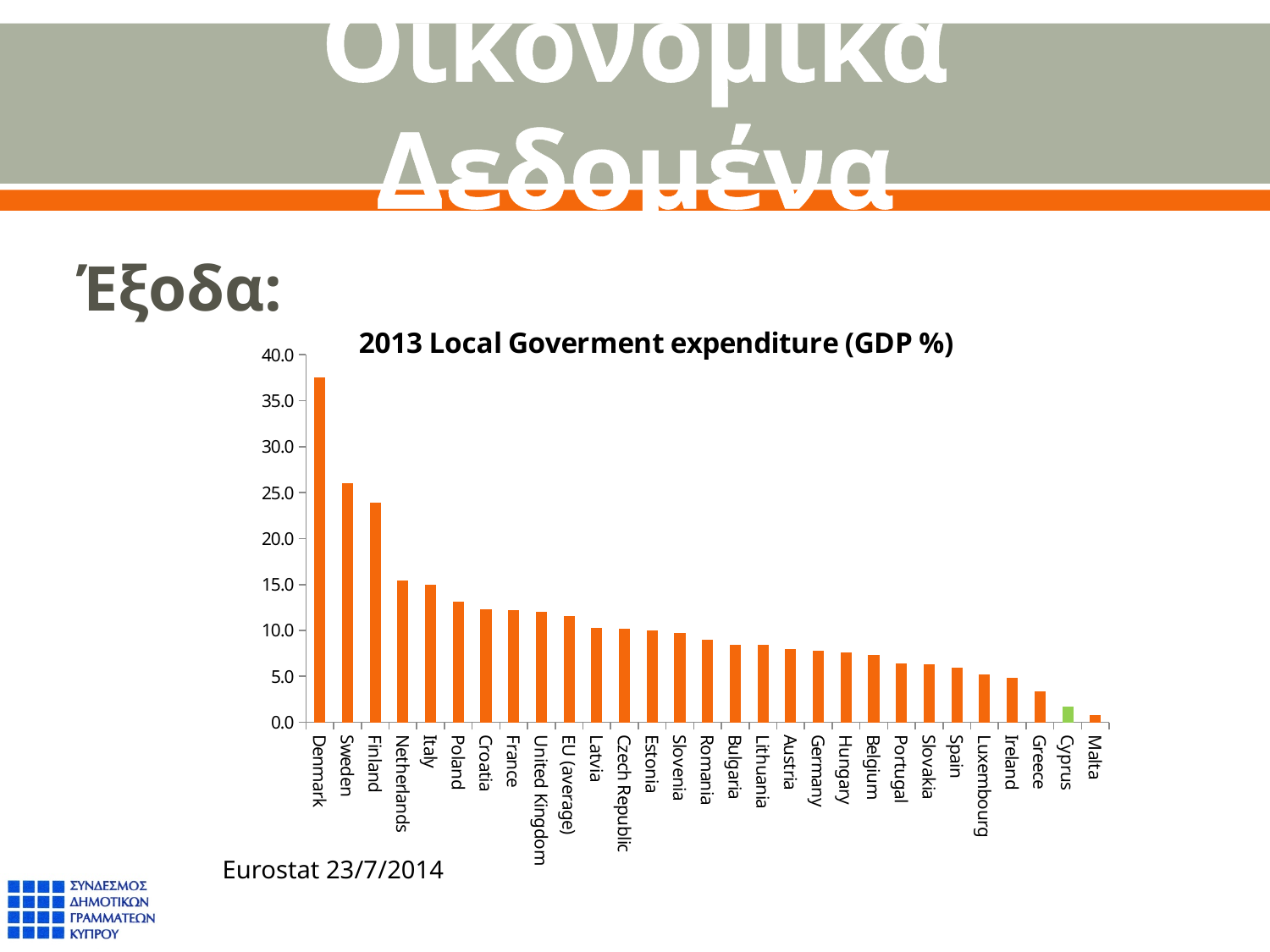
Do the values rise or fall moving from left to right along the x axis? fall What is the title of the chart? 2013 Local Goverment expenditure (GDP %) How many categories (bars) are plotted in the chart? 29 Is the value for Finland greater or less than 20? greater Which has a higher value, Sweden or Finland? Sweden Is the value for Cyprus greater or less than 5? less Is the value for Denmark greater or less than 35? greater Which country has the lowest local government expenditure in the chart? Malta What kind of chart is shown on the slide? bar chart Which country's bar is shown in a different colour (green) from the others? Cyprus Which country has the highest local government expenditure in the chart? Denmark